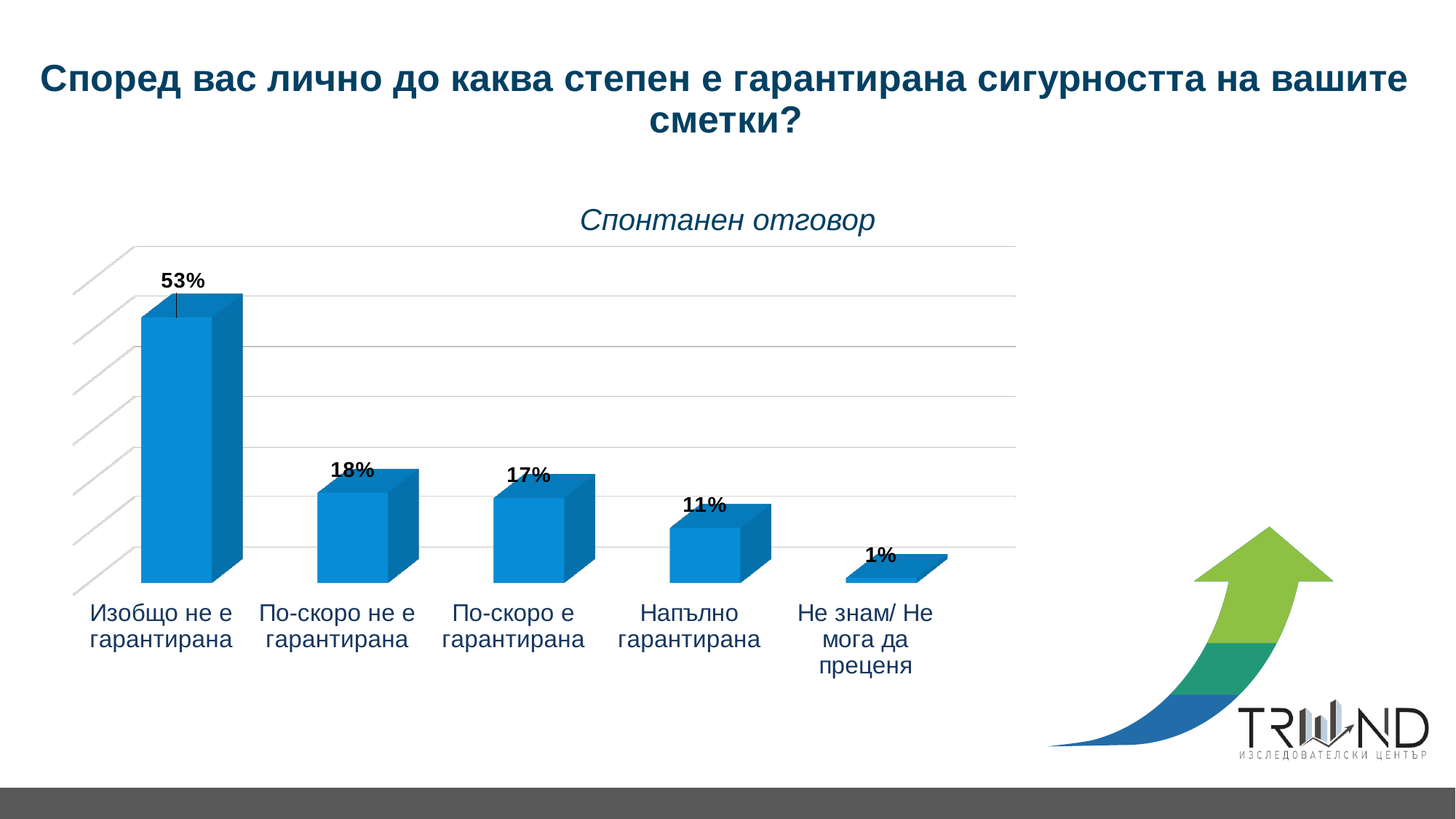
Which category has the highest value? Изобщо не е гарантирана What is the title of the chart? Спонтанен отговор What is the difference between the values for "Изобщо не е гарантирана" and "По-скоро не е гарантирана"? 35% What is the value for "По-скоро не е гарантирана"? 18% What is the value for "Не знам/ Не мога да преценя"? 1% What is the value for "Изобщо не е гарантирана"? 53% What is the value for "По-скоро е гарантирана"? 17% Which category has the lowest value? Не знам/ Не мога да преценя Which is larger, the value for "Напълно гарантирана" or the value for "По-скоро е гарантирана"? По-скоро е гарантирана How many categories are shown in the chart? 5 What kind of chart is shown on the slide? Bar chart What is the value for "Напълно гарантирана"? 11%